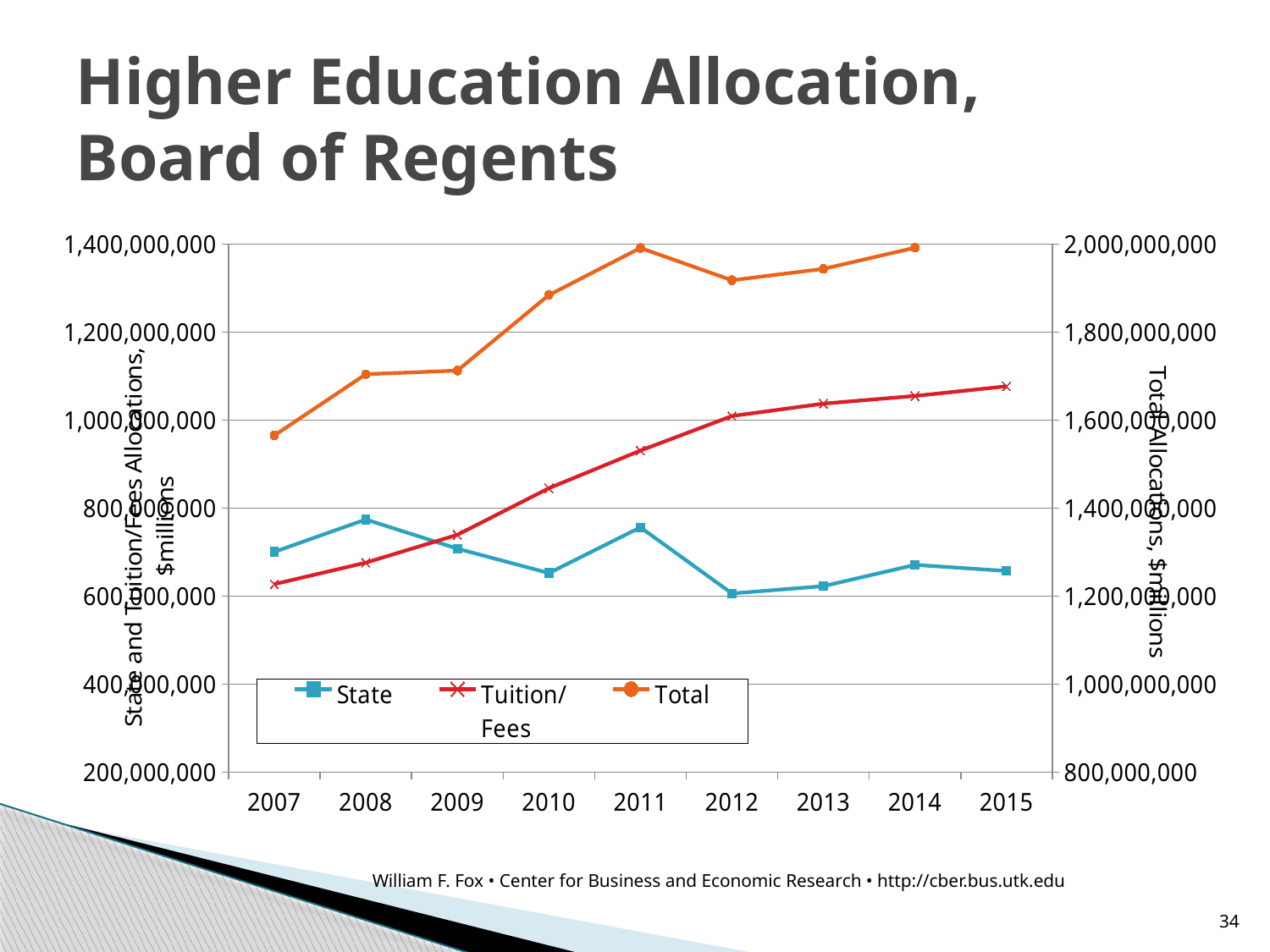
How many years are shown on the x axis? 9 Is the Tuition/Fees value for 2007 greater or less than 800,000,000? less Does the Tuition/Fees series rise or fall from 2007 to 2015? rise How many series does the legend list? 3 In 2015, which is larger: the State value or the Tuition/Fees value? Tuition/Fees In which year is the Tuition/Fees value highest? 2015 In which year is the Tuition/Fees value lowest? 2007 Is the Total value for 2011 greater or less than 1,800,000,000 on the right axis? greater Is the State value for 2008 greater or less than 600,000,000? greater What kind of chart is shown on the slide? line chart In which year is the Total value lowest? 2007 In which year is the State value lowest? 2012